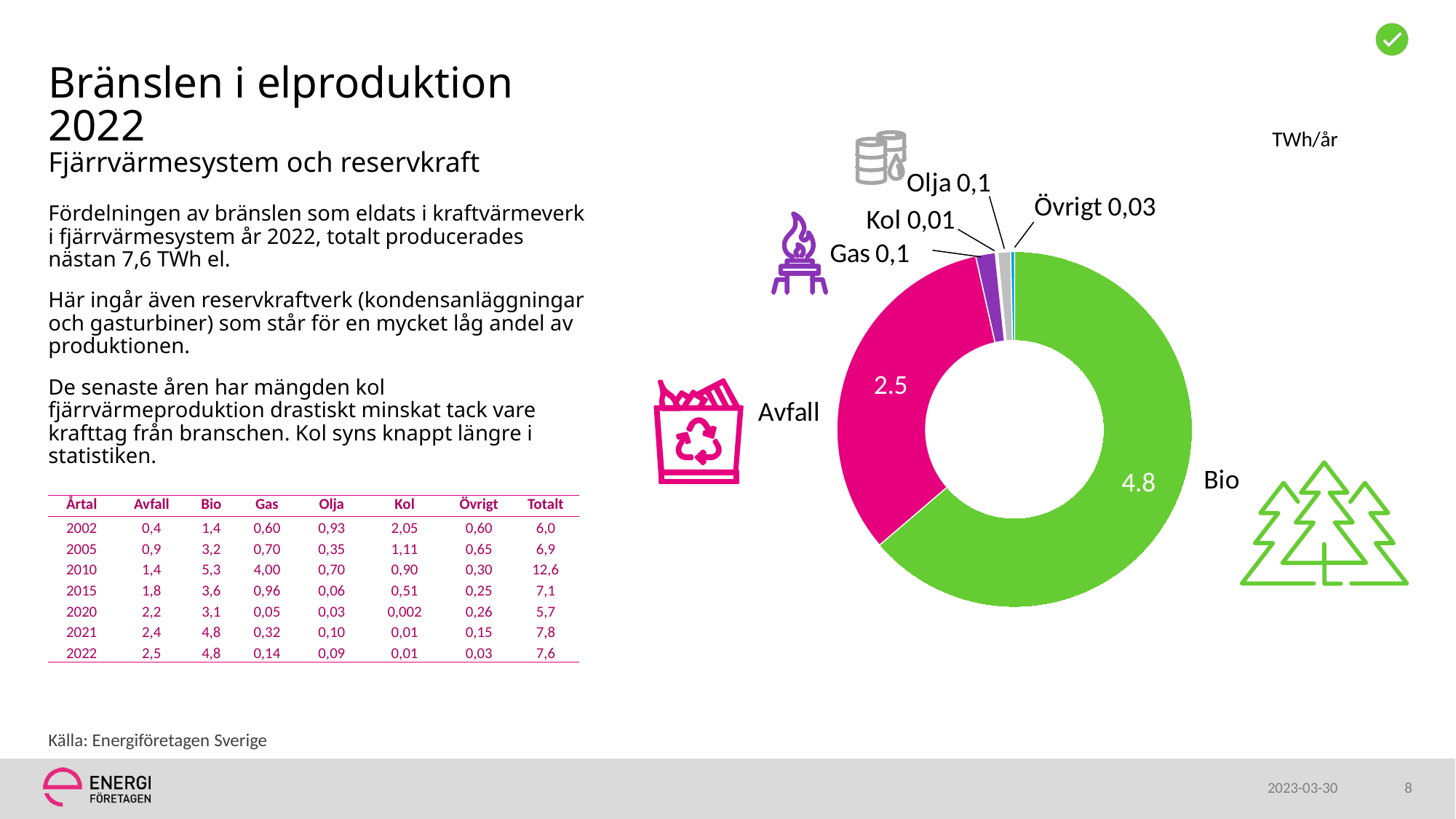
Which is larger in the donut chart, Avfall or Gas? Avfall What value is shown for Avfall in the donut chart? 2.5 What value is shown for Kol in the donut chart? 0,01 What unit is indicated for the values in the donut chart? TWh/år How many fuel categories are shown in the donut chart? 6 Which fuel has the largest slice in the donut chart? Bio What is the difference between the values for Bio and Avfall in the donut chart? 2.3 What value is shown for Gas in the donut chart? 0,1 What value is shown for Bio in the donut chart? 4.8 What kind of chart is shown on the slide? Pie (donut) chart Which fuel has the smallest value in the donut chart? Kol What value is shown for Övrigt in the donut chart? 0,03